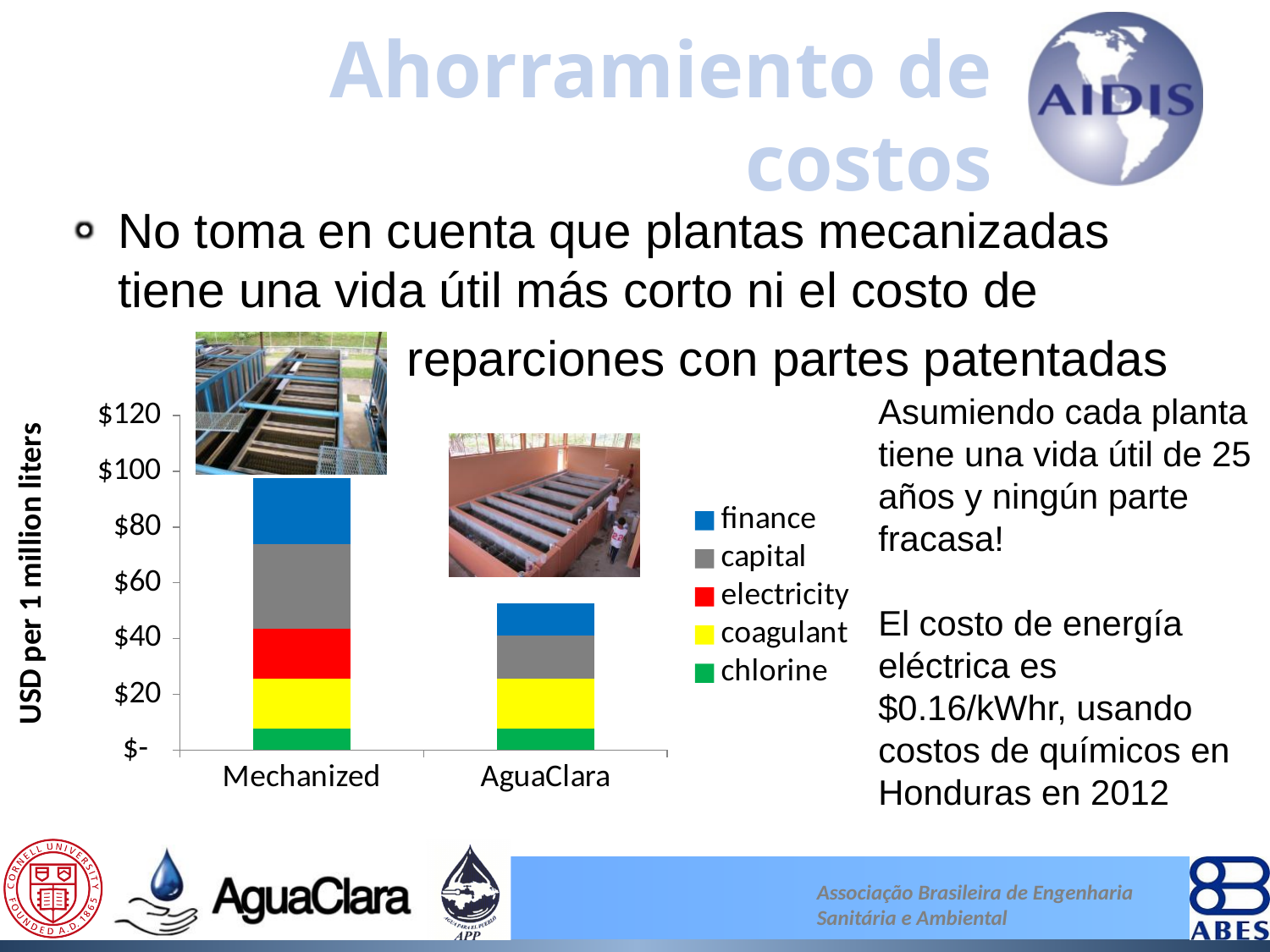
How many categories are shown on the x axis of the chart? 2 How many series does the chart's legend list? 5 What is the title of the chart's vertical axis? USD per 1 million liters Is the total value of the Mechanized bar greater or less than $80? greater Which category has the taller stacked bar, Mechanized or AguaClara? Mechanized Which category's bar has no electricity segment? AguaClara Which category has the lowest total cost in the chart? AguaClara Which series is shown in red in the chart's legend? electricity Is the total value of the Mechanized bar greater or less than $100? less What kind of chart is shown on the slide? stacked bar chart Is the total value of the AguaClara bar greater or less than $60? less